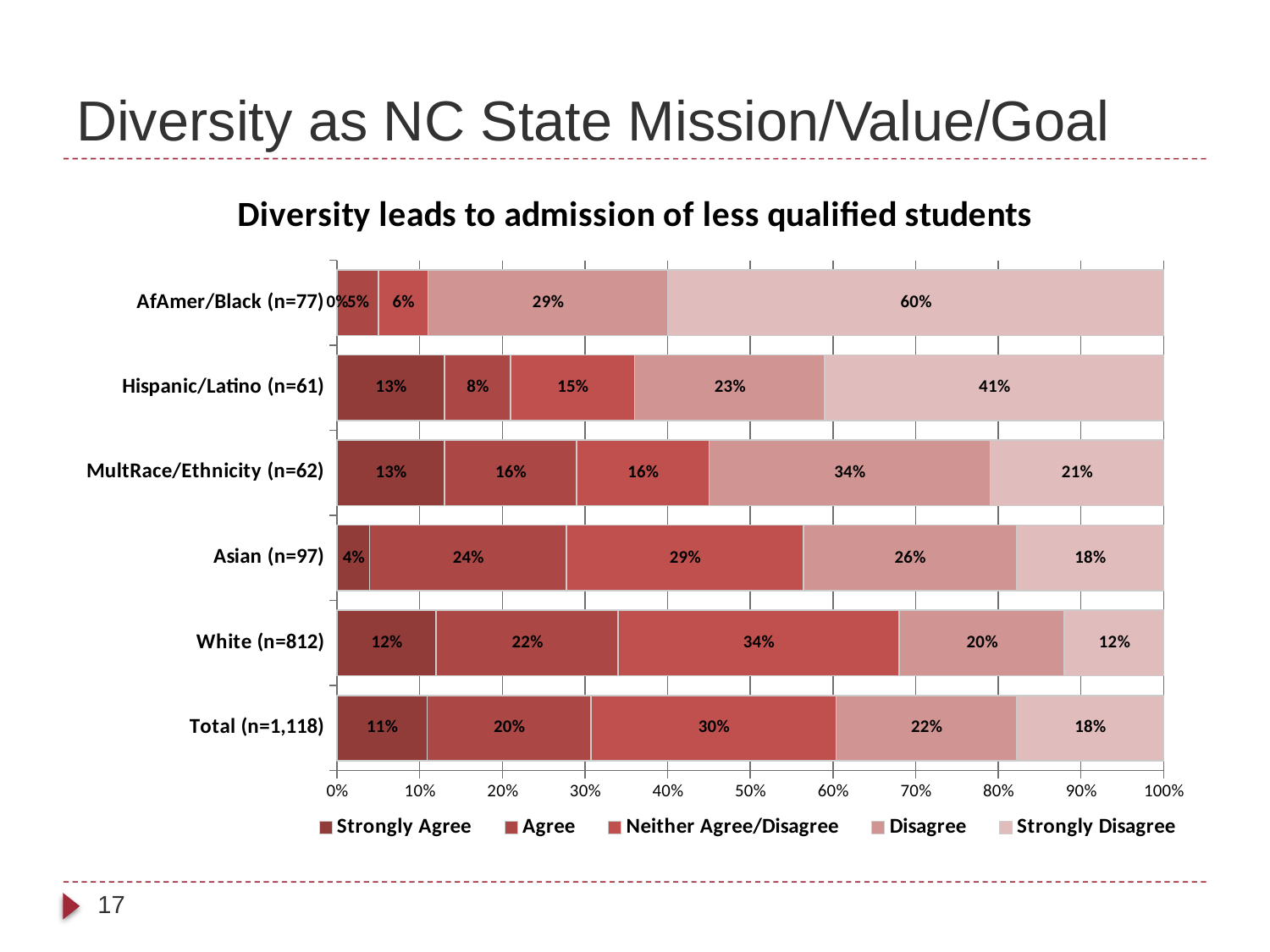
What percentage of White (n=812) respondents selected Neither Agree/Disagree? 34% Which group has the lowest Strongly Agree percentage? AfAmer/Black (n=77) What is the Strongly Agree value for Total (n=1,118)? 11% What is the Agree value for Asian (n=97)? 24% What percentage of Hispanic/Latino (n=61) respondents selected Strongly Disagree? 41% Which is larger: the Strongly Disagree value for Asian (n=97) or for White (n=812)? Asian (n=97) How many groups (bars) are shown in the chart? 6 What type of chart is shown on the slide? Stacked bar chart How many series does the legend list? 5 What is the difference between the Disagree values for MultRace/Ethnicity (n=62) and White (n=812)? 14% What is the title of the chart? Diversity leads to admission of less qualified students Which group has the highest Strongly Disagree percentage? AfAmer/Black (n=77)